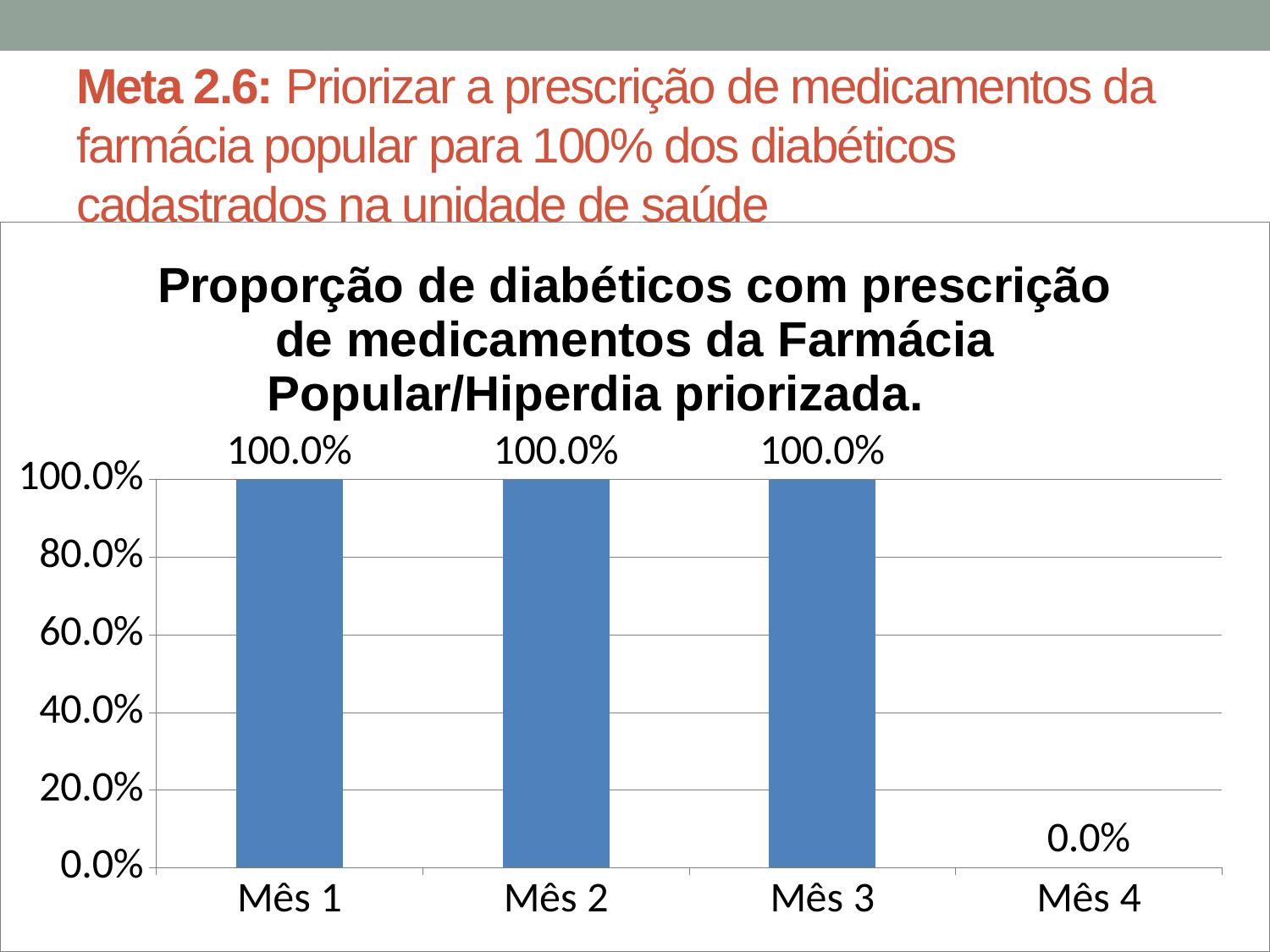
What is the highest value shown on the y axis? 100.0% What is the difference between the values for Mês 2 and Mês 4? 100.0% Is the value for Mês 2 greater or less than 80.0%? greater Which is larger, the value for Mês 3 or the value for Mês 4? Mês 3 What is the value for Mês 3? 100.0% What is the value for Mês 1? 100.0% How many categories are shown on the x axis? 4 Do the values rise or fall from Mês 3 to Mês 4? fall What is the value for Mês 4? 0.0% What is the title of the chart? Proporção de diabéticos com prescrição de medicamentos da Farmácia Popular/Hiperdia priorizada. What kind of chart is shown on the slide? bar chart Which category has the lowest value? Mês 4